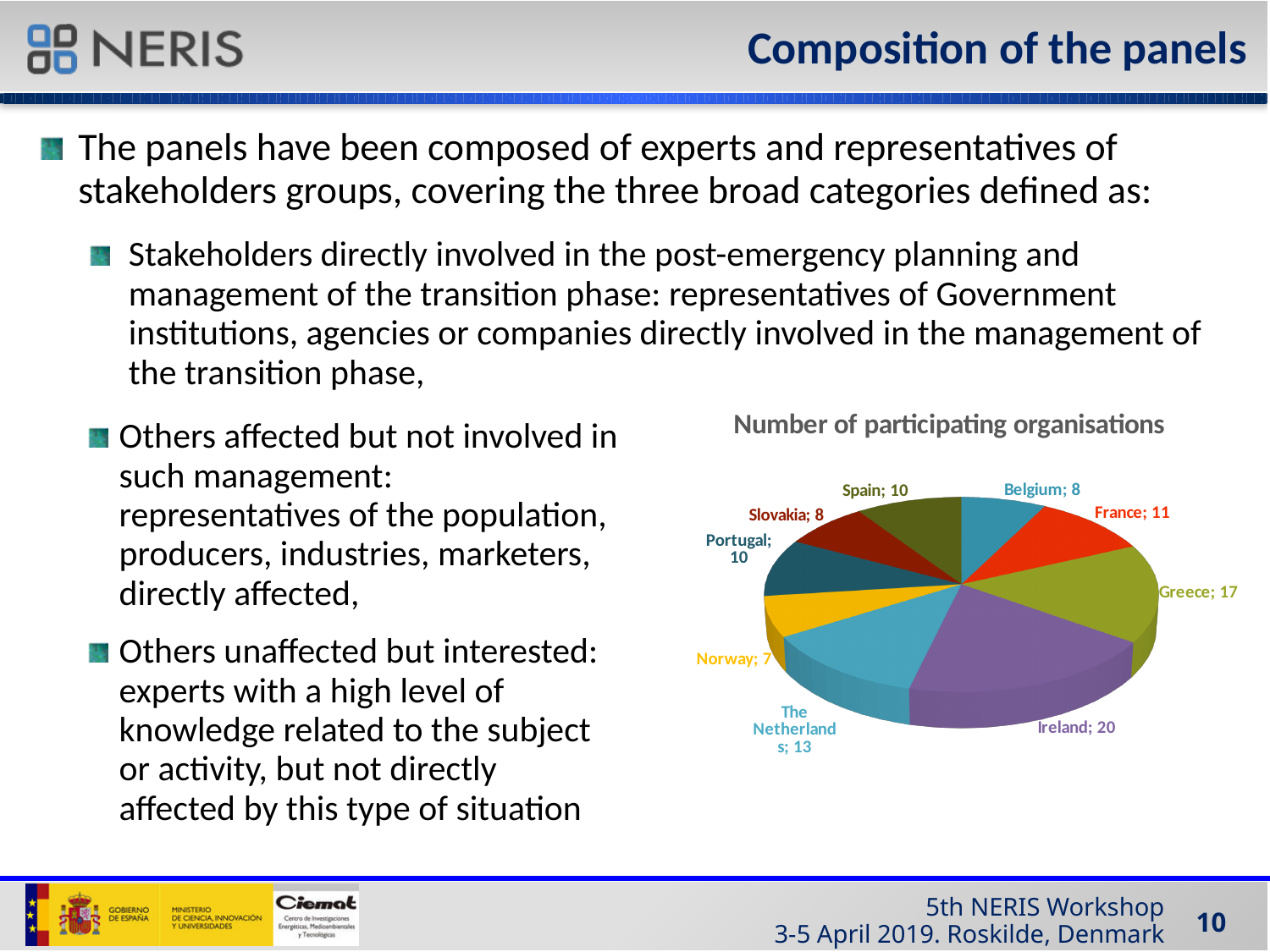
How many participating organisations does the chart show for Greece? 17 What is the total number of participating organisations across all countries in the pie chart? 104 How many countries are shown in the pie chart? 9 Which country has the smallest number of participating organisations? Norway Which two countries both have 8 participating organisations? Belgium and Slovakia What kind of chart is shown on the slide? pie chart How many participating organisations does the chart show for Ireland? 20 What is the difference between the number of participating organisations for Ireland and for France? 9 What is the title of the chart? Number of participating organisations How many participating organisations does the chart show for The Netherlands? 13 Which has more participating organisations, Greece or The Netherlands? Greece Which country has the largest number of participating organisations? Ireland